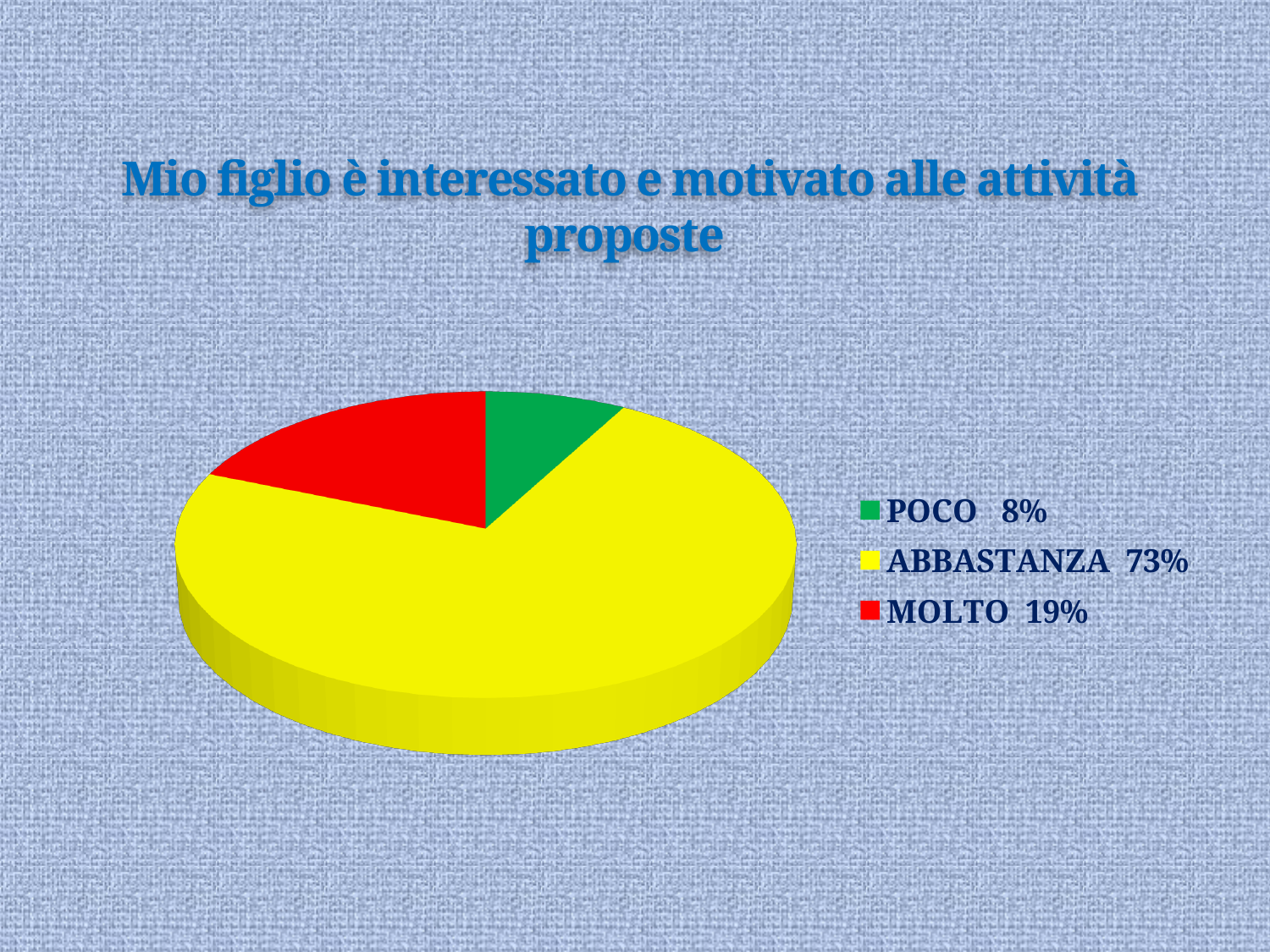
What percentage is shown for MOLTO? 19% What percentage is shown for ABBASTANZA? 73% What is the difference in percentage points between ABBASTANZA and MOLTO? 54 What is the difference in percentage points between MOLTO and POCO? 11 What colour is the slice for ABBASTANZA? yellow What is the title of the chart? Mio figlio è interessato e motivato alle attività proposte Which category has the smallest share of the pie? POCO What percentage is shown for POCO? 8% Which is larger, the share for MOLTO or the share for POCO? MOLTO What kind of chart is shown on the slide? pie chart How many categories does the pie chart have? 3 Which category has the largest share of the pie? ABBASTANZA